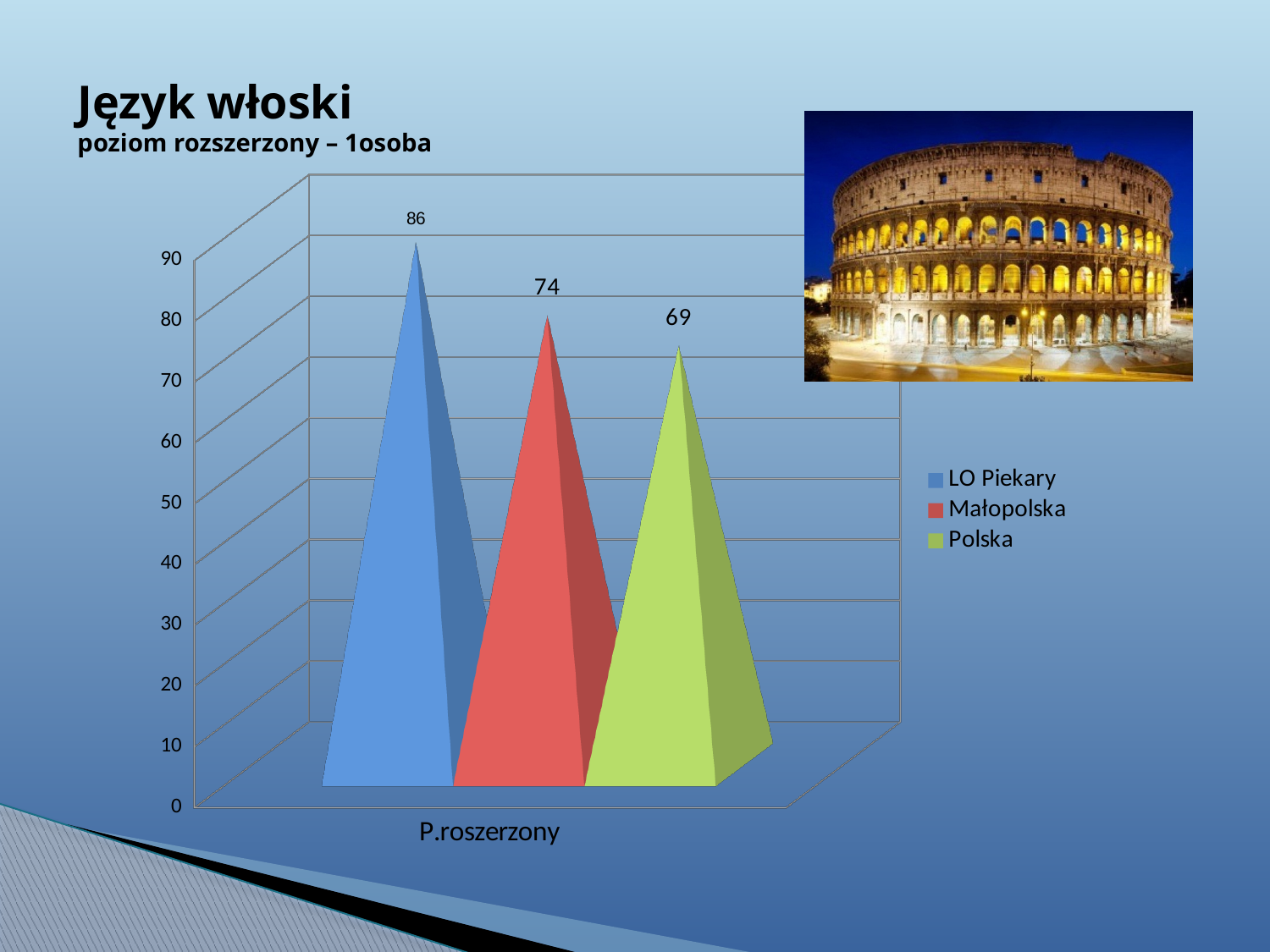
What is the category label shown on the x axis? P.roszerzony Which is larger, the value for Małopolska or the value for Polska? Małopolska What is the value for Polska? 69 What is the value for LO Piekary? 86 Which series has the lowest value? Polska What is the difference between the values for Małopolska and Polska? 5 What is the value for Małopolska? 74 How many series does the legend list? 3 Which series has the highest value? LO Piekary What kind of chart is shown on the slide? bar chart What is the difference between the values for LO Piekary and Polska? 17 Is the value for LO Piekary greater or less than 80? greater